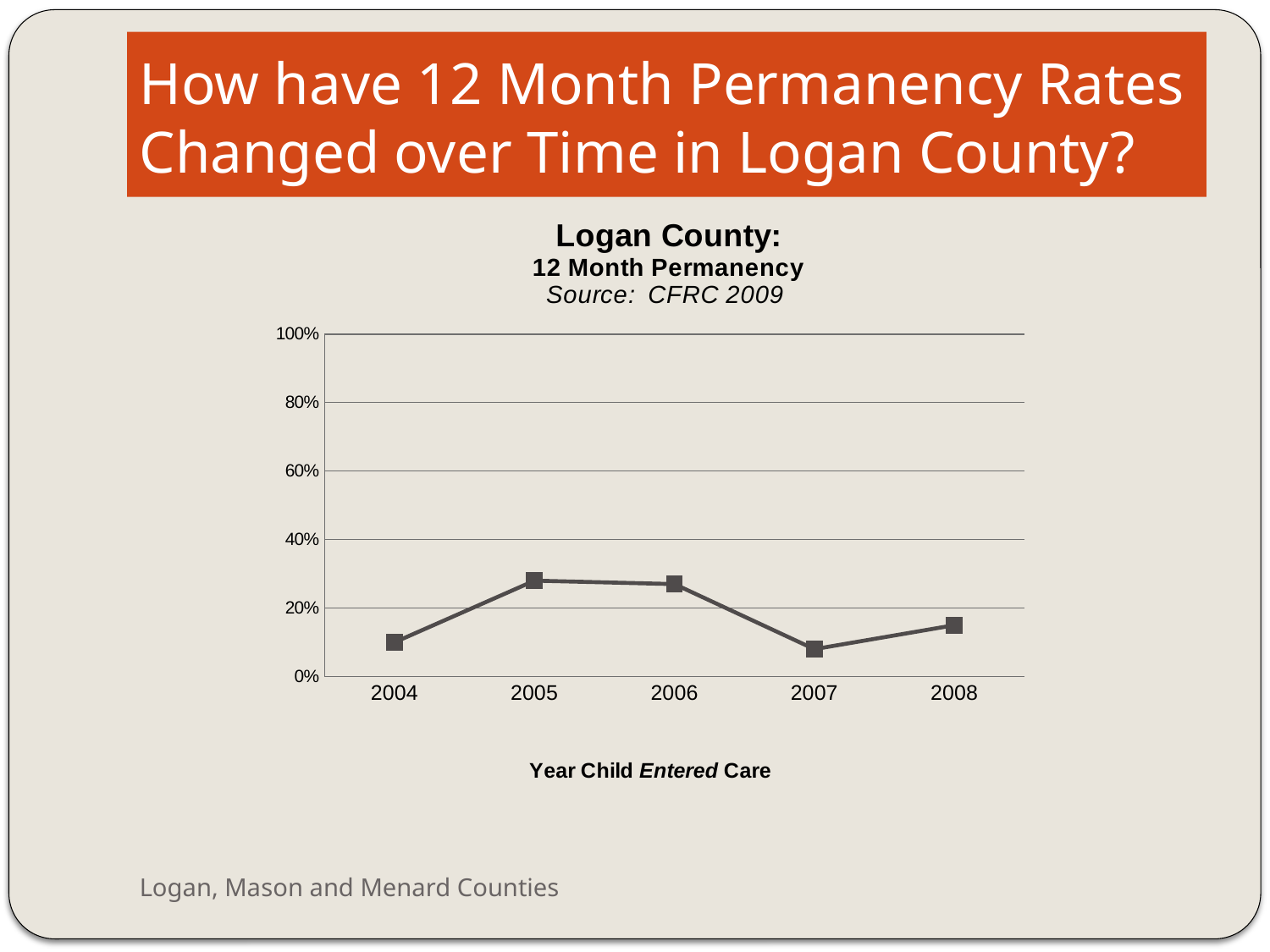
How many years are plotted on the x axis of the chart? 5 What is the label of the x axis of the chart? Year Child Entered Care What kind of chart is shown on the slide? line chart Is the 12 month permanency rate for 2004 greater or less than 20%? less Does the 12 month permanency rate rise or fall from 2006 to 2007? fall Which year has the higher 12 month permanency rate, 2004 or 2005? 2005 Is the 12 month permanency rate for 2007 greater or less than 20%? less Is the 12 month permanency rate for 2008 greater or less than 20%? less Which year has the higher 12 month permanency rate, 2007 or 2008? 2008 What source is cited in the chart title? CFRC 2009